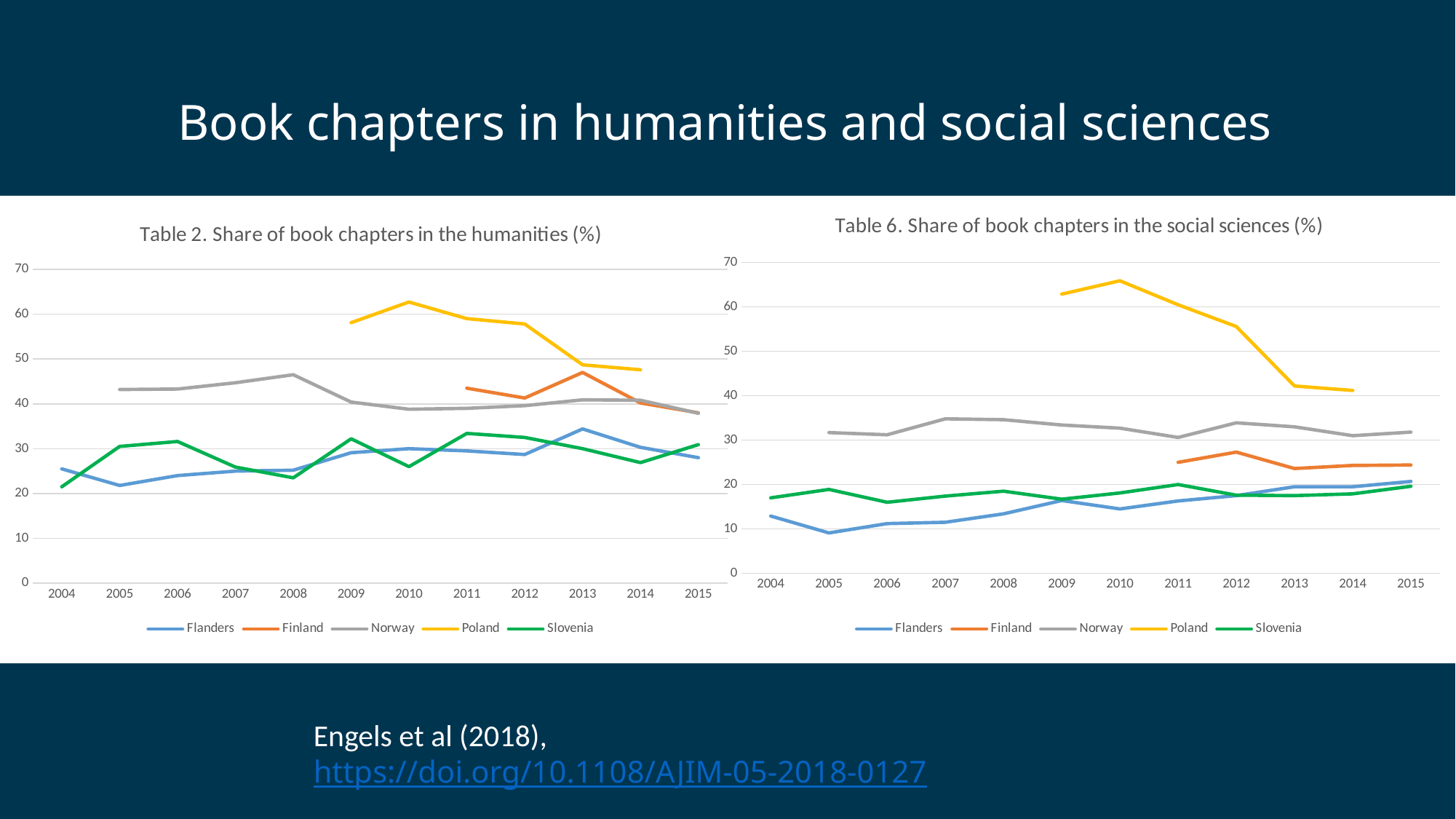
Which colour is used for the Poland series in both charts? yellow In 'Table 6. Share of book chapters in the social sciences (%)', is the value for Norway in 2007 greater or less than 30? greater In 'Table 2. Share of book chapters in the humanities (%)', which series has the highest value in 2010? Poland In 'Table 6. Share of book chapters in the social sciences (%)', is the value for Flanders in 2005 greater or less than 10? less In 'Table 6. Share of book chapters in the social sciences (%)', which is larger in 2012: Poland or Norway? Poland In 'Table 6. Share of book chapters in the social sciences (%)', does the Poland line rise or fall from 2010 to 2014? fall What type of chart is 'Table 2. Share of book chapters in the humanities (%)'? line chart How many years are shown on the x axis of 'Table 2. Share of book chapters in the humanities (%)'? 12 How many series does the legend of 'Table 6. Share of book chapters in the social sciences (%)' list? 5 In 'Table 2. Share of book chapters in the humanities (%)', which is larger in 2013: Finland or Norway? Finland In 'Table 6. Share of book chapters in the social sciences (%)', which series has the lowest value in 2005? Flanders In 'Table 2. Share of book chapters in the humanities (%)', is the value for Poland in 2010 greater or less than 60? greater